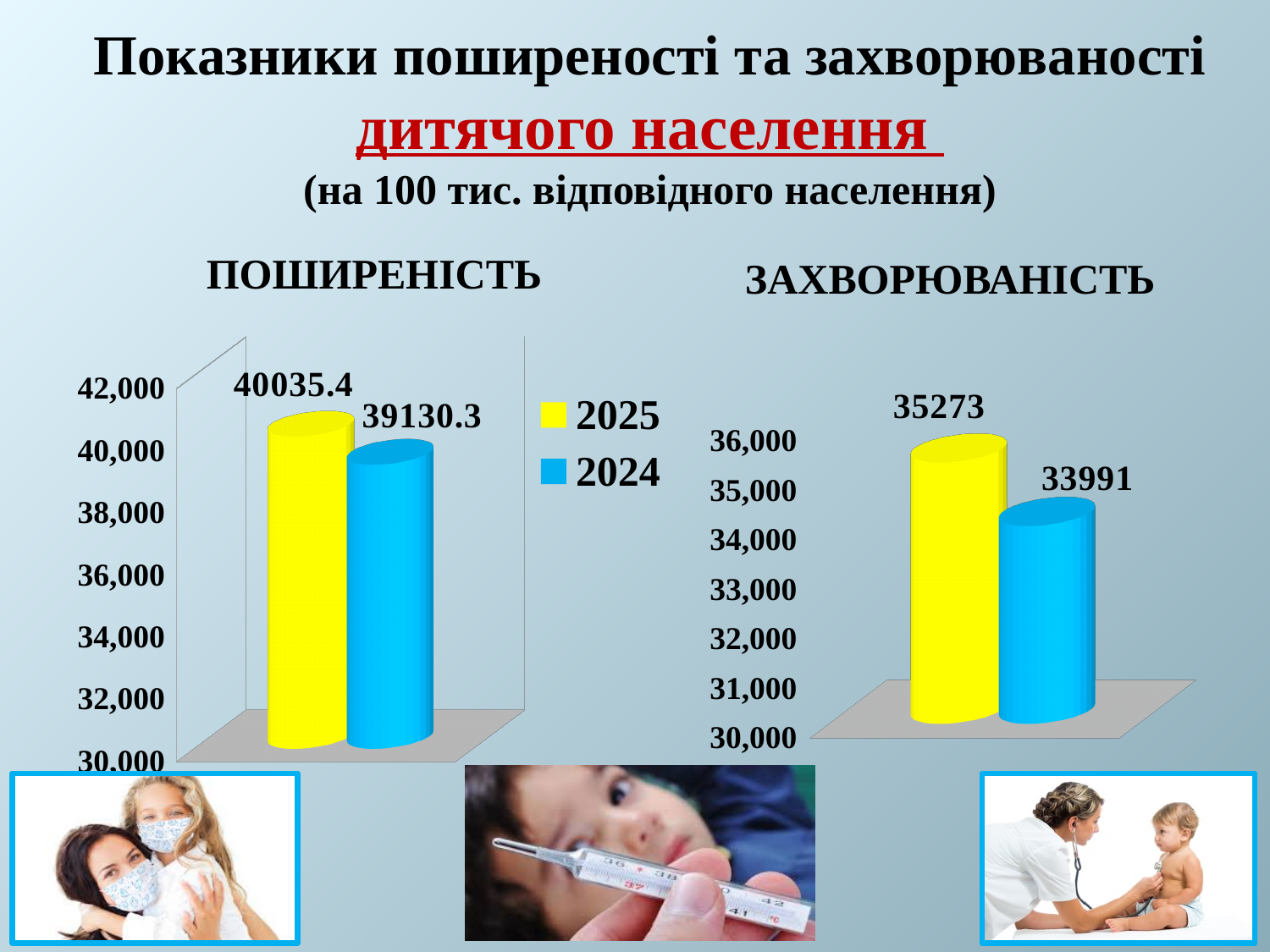
In the ЗАХВОРЮВАНІСТЬ chart, is the value for 2024 greater or less than 34,000? less In the legend, which colour represents 2025? yellow In the ПОШИРЕНІСТЬ chart, what is the value for 2025? 40035.4 In the ПОШИРЕНІСТЬ chart, what is the difference between the 2025 and 2024 values? 905.1 In the ЗАХВОРЮВАНІСТЬ chart, what is the value for 2024? 33991 In the ЗАХВОРЮВАНІСТЬ chart, what is the value for 2025? 35273 In the ПОШИРЕНІСТЬ chart, which year has the higher value? 2025 In the ЗАХВОРЮВАНІСТЬ chart, what is the difference between the 2025 and 2024 values? 1282 What kind of chart is the ПОШИРЕНІСТЬ chart? bar chart In the ПОШИРЕНІСТЬ chart, what is the value for 2024? 39130.3 In the ЗАХВОРЮВАНІСТЬ chart, which year has the lower value? 2024 How many series does the legend list? 2